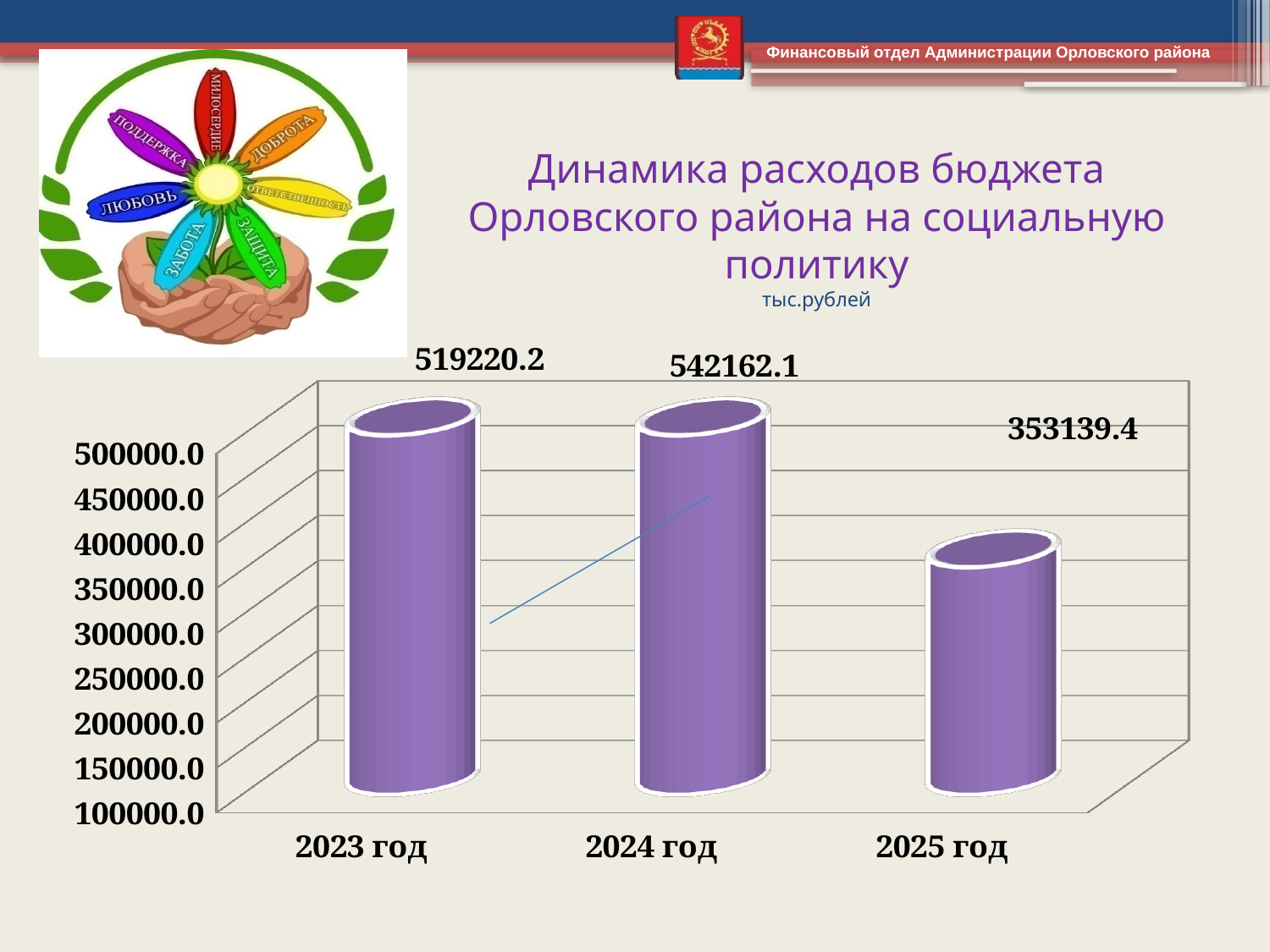
Which year has the lowest value? 2025 год What is the value for 2023 год? 519220.2 In what units are the values on the chart expressed? тыс.рублей What is the value for 2024 год? 542162.1 Is the value for 2025 год greater or less than 400000.0? less How many years are shown on the chart? 3 What is the difference between the values for 2024 год and 2025 год? 189022.7 Which is larger, the value for 2023 год or the value for 2025 год? 2023 год What is the difference between the values for 2024 год and 2023 год? 22941.9 Which year has the highest value? 2024 год What kind of chart is shown on the slide? bar chart What is the value for 2025 год? 353139.4